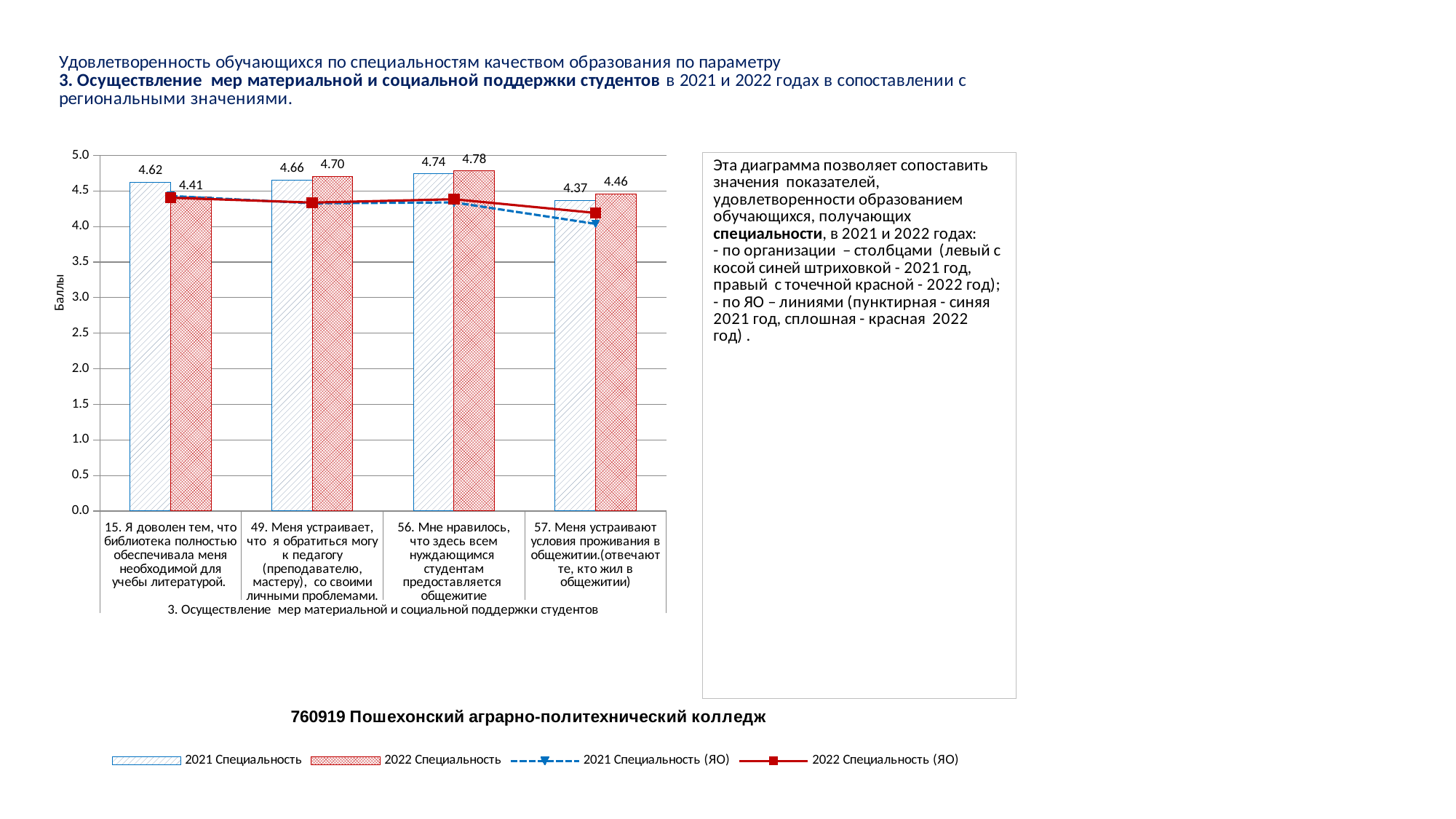
What is the value of the 2021 Специальность bar for question 56 (Мне нравилось, что здесь всем нуждающимся студентам предоставляется общежитие)? 4.74 How many series does the chart legend list? 4 Which question has the highest 2022 Специальность bar? 56. Мне нравилось, что здесь всем нуждающимся студентам предоставляется общежитие For question 15, what is the difference between the 2021 Специальность value and the 2022 Специальность value? 0.21 What is the value of the 2022 Специальность bar for question 57 (Меня устраивают условия проживания в общежитии)? 4.46 Which question has the lowest 2021 Специальность bar? 57. Меня устраивают условия проживания в общежитии What is the value of the 2021 Специальность bar for question 15 (Я доволен тем, что библиотека полностью обеспечивала меня необходимой для учебы литературой)? 4.62 How many questions (categories) are shown on the x axis of the chart? 4 Is the value of the 2021 Специальность (ЯО) line for question 57 greater or less than 4.5? less For question 56, what is the difference between the 2022 Специальность value and the 2021 Специальность value? 0.04 For question 49, which is larger: the 2021 Специальность bar or the 2022 Специальность bar? 2022 Специальность What is the label of the vertical axis of the chart? Баллы